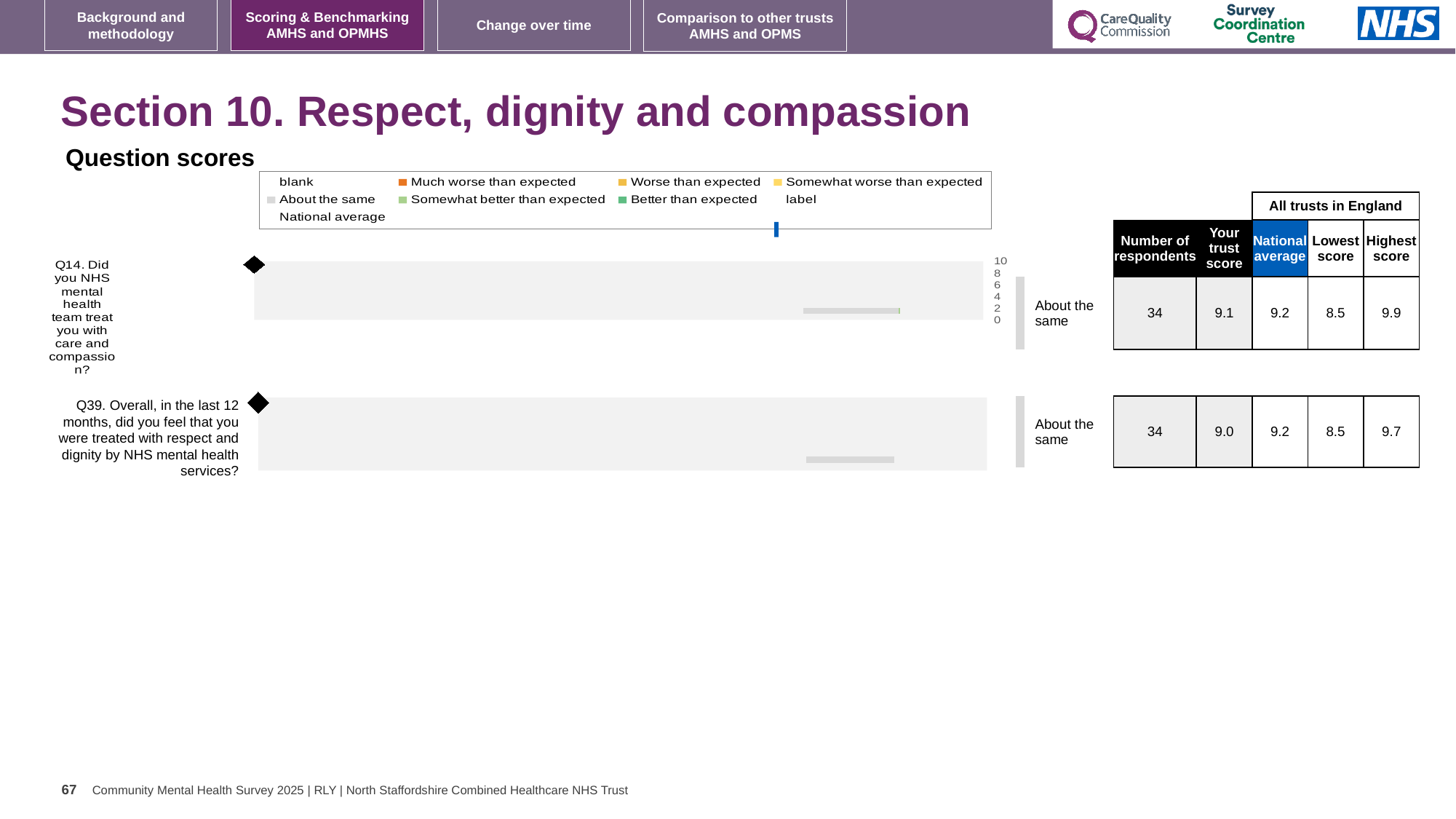
What is the national average score for Q39? 9.2 What is the trust score for Q14 (care and compassion) shown in the table beside the chart? 9.1 What colour is used in the legend for 'Much worse than expected'? orange Which question has the higher trust score, Q14 or Q39? Q14 What is the trust score for Q39 (respect and dignity) shown in the table beside the chart? 9.0 How many respondents answered Q14? 34 What is the highest score among all trusts in England for Q39? 9.7 What is the difference between the highest score and the lowest score for Q14? 1.4 By how much is the national average for Q39 higher than the trust score for Q39? 0.2 What benchmark category is shown next to the Q14 chart? About the same How many questions are plotted in the question scores charts? 2 What kind of chart is used to show the question scores for Q14 and Q39? bar chart